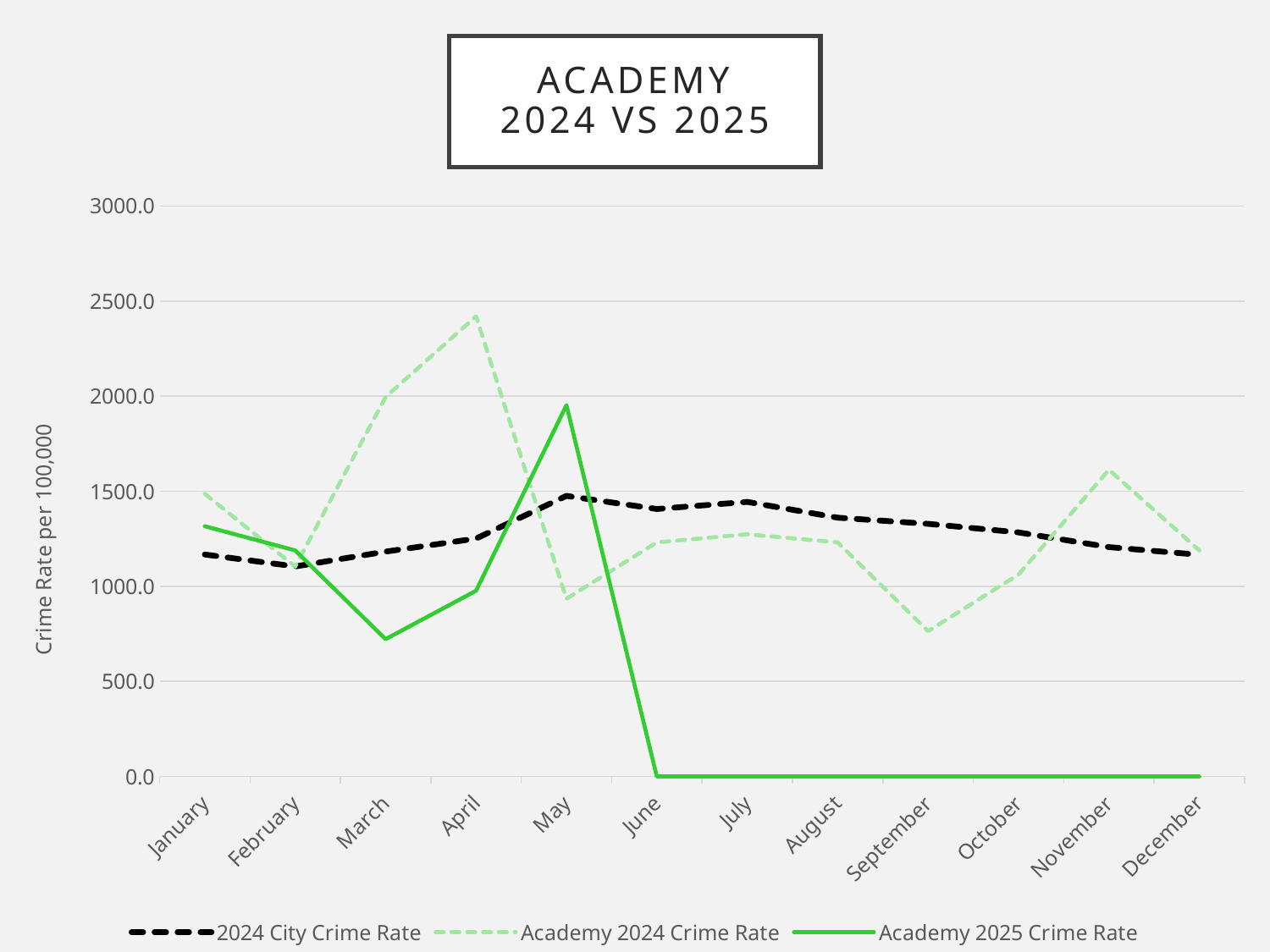
Is the Academy 2024 Crime Rate in April greater or less than 2000.0? greater What kind of chart is shown on the slide? line chart Is the Academy 2025 Crime Rate in March greater or less than 1000.0? less Is the Academy 2024 Crime Rate in September greater or less than 1000.0? less What is the label on the vertical axis? Crime Rate per 100,000 In which month does the Academy 2024 Crime Rate reach its highest value? April In March, which is higher: the Academy 2024 Crime Rate or the Academy 2025 Crime Rate? Academy 2024 Crime Rate In which month is the Academy 2024 Crime Rate at its lowest? September How many months are plotted along the x axis? 12 How many series does the legend list? 3 In May, which is higher: the Academy 2025 Crime Rate or the 2024 City Crime Rate? Academy 2025 Crime Rate In which month does the Academy 2025 Crime Rate reach its highest value? May